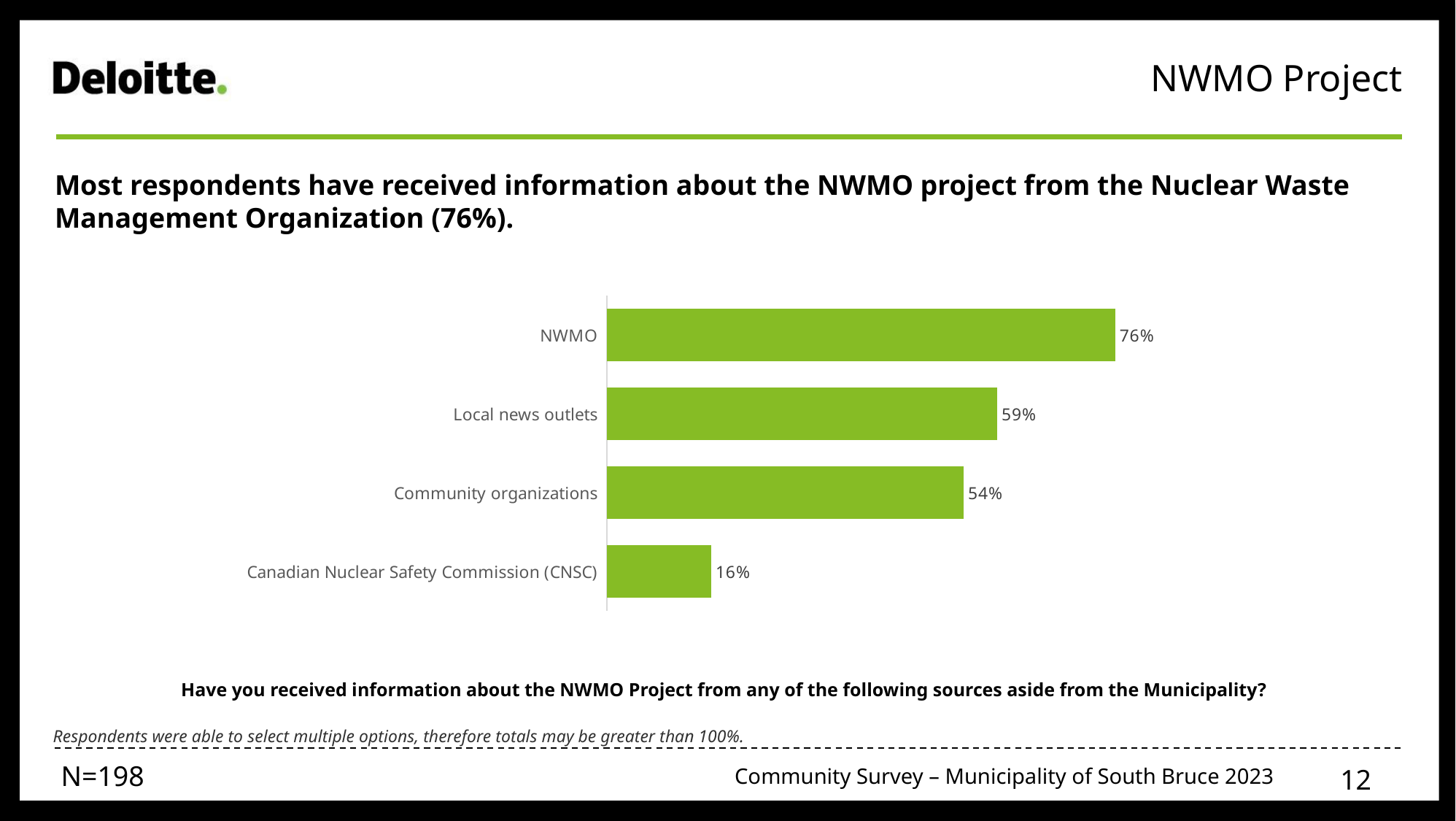
Which information source has the highest percentage of respondents? NWMO What percentage of respondents received information about the NWMO project from NWMO? 76% What is the sample size (N) shown on the slide? N=198 What percentage of respondents received information from the Canadian Nuclear Safety Commission (CNSC)? 16% What percentage of respondents received information from community organizations? 54% What is the difference in percentage points between community organizations and the Canadian Nuclear Safety Commission (CNSC)? 38 percentage points Which has a higher percentage: local news outlets or community organizations? Local news outlets Which information source has the lowest percentage of respondents? Canadian Nuclear Safety Commission (CNSC) What is the difference in percentage points between NWMO and local news outlets? 17 percentage points What type of chart is shown on the slide? Bar chart How many information sources are shown in the chart? 4 What percentage of respondents received information from local news outlets? 59%